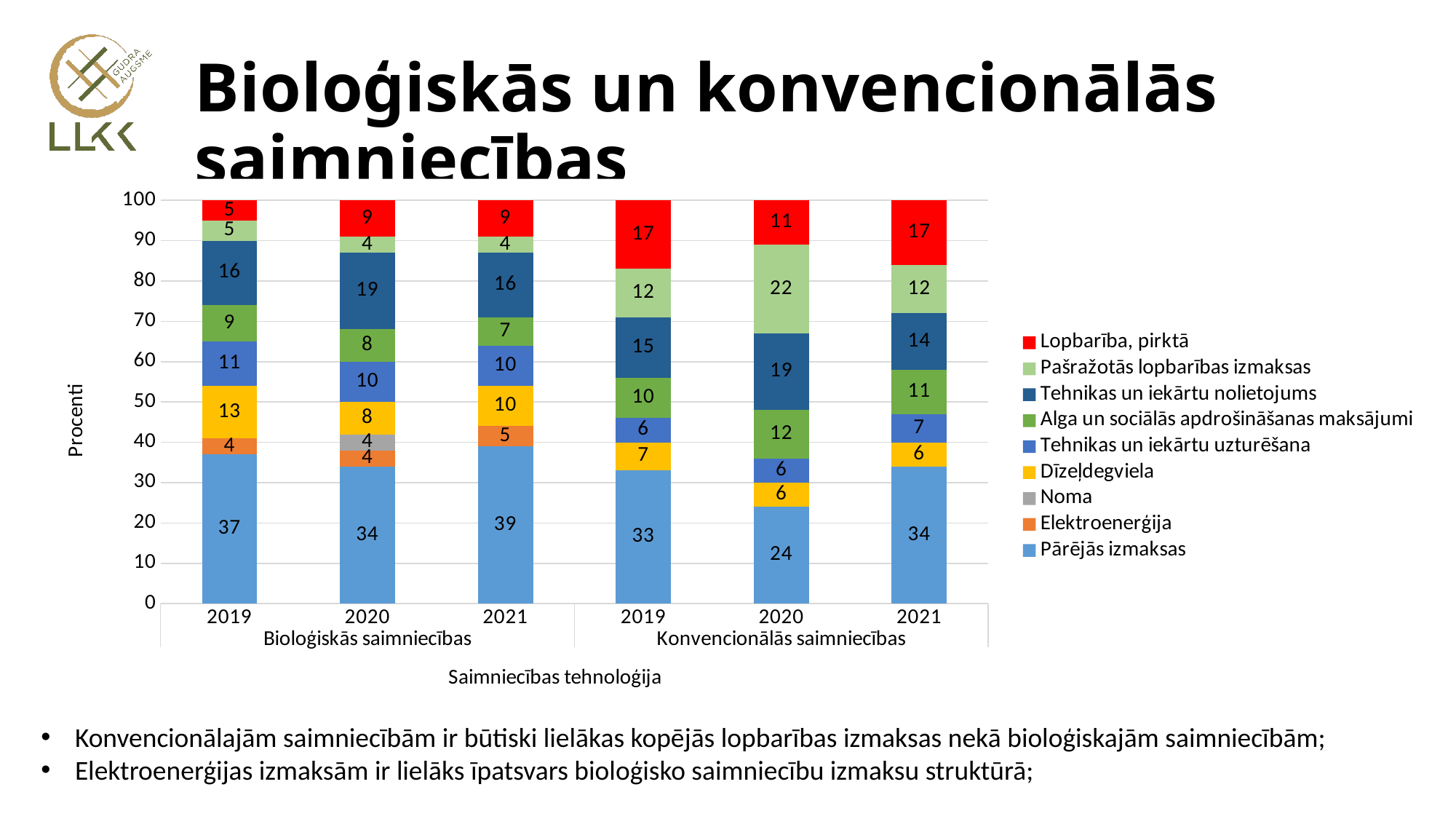
How many bars are plotted in the chart? 6 What is the value of Pārējās izmaksas for Bioloģiskās saimniecības in 2021? 39 Which bar has the lowest value for Pārējās izmaksas? Konvencionālās saimniecības 2020 What is the value of Lopbarība, pirktā for Bioloģiskās saimniecības in 2019? 5 What is the label of the y axis? Procenti What is the difference between Lopbarība, pirktā for Konvencionālās saimniecības 2019 and Bioloģiskās saimniecības 2019? 12 How many series does the legend list? 9 What type of chart is shown on the slide? Stacked bar chart Which is larger: Dīzeļdegviela for Bioloģiskās saimniecības 2019 or for Konvencionālās saimniecības 2019? Bioloģiskās saimniecības 2019 What is the value of Pašražotās lopbarības izmaksas for Konvencionālās saimniecības in 2020? 22 Which bar has the highest value for Pašražotās lopbarības izmaksas? Konvencionālās saimniecības 2020 In which bar does the Noma series appear? Bioloģiskās saimniecības 2020